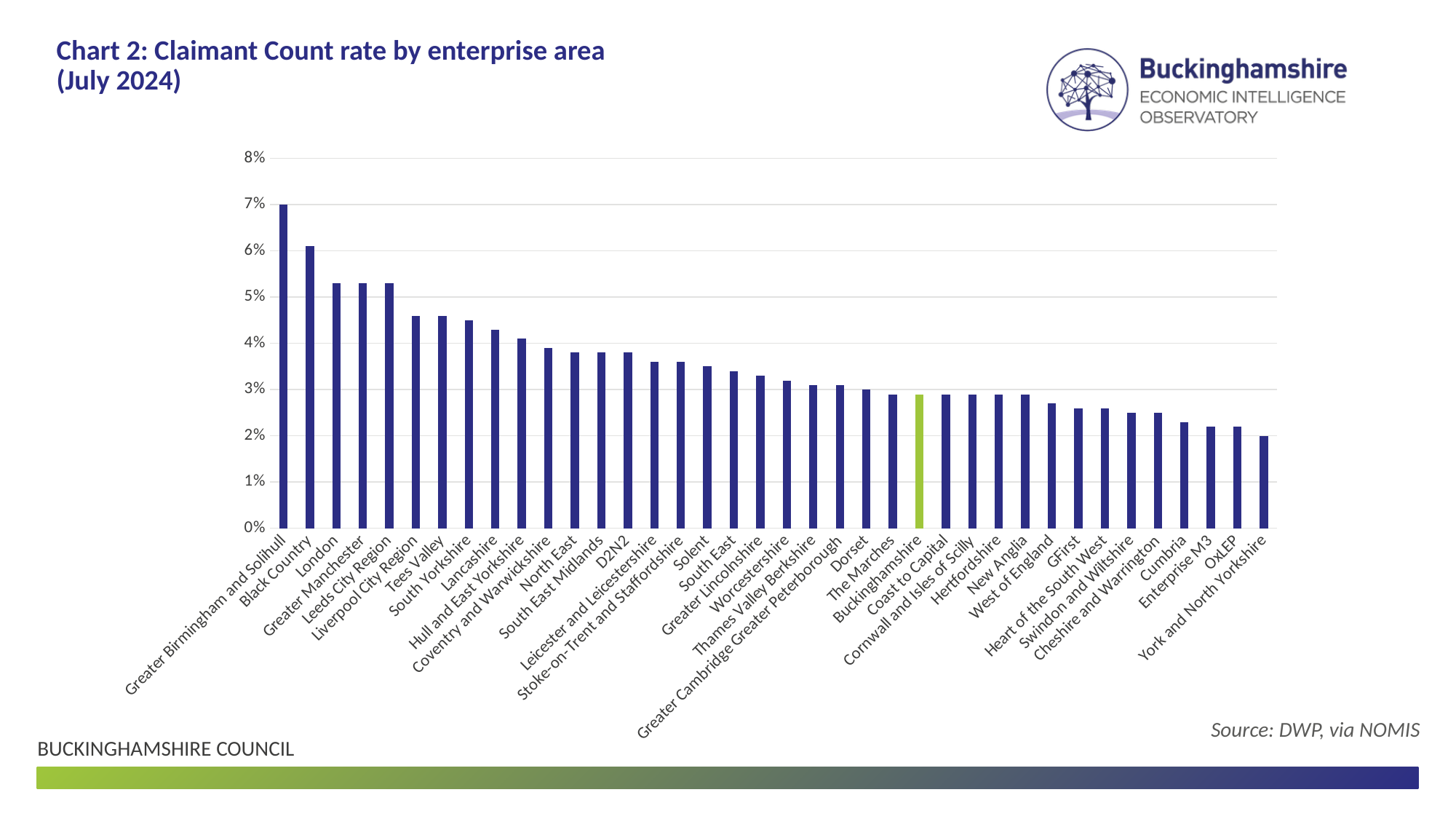
Is the Claimant Count rate for Tees Valley greater or less than 5%? less Is the Claimant Count rate for Cumbria greater or less than 2%? greater Which enterprise area's bar is highlighted in green? Buckinghamshire Which enterprise area has the highest Claimant Count rate? Greater Birmingham and Solihull Is the Claimant Count rate for London greater or less than 5%? greater What kind of chart is shown on the slide? bar chart Which has a higher Claimant Count rate, Black Country or Greater Manchester? Black Country Do the Claimant Count rates rise or fall moving from left to right along the x axis? fall How many enterprise areas are plotted on the chart? 38 Which enterprise area has the lowest Claimant Count rate? York and North Yorkshire